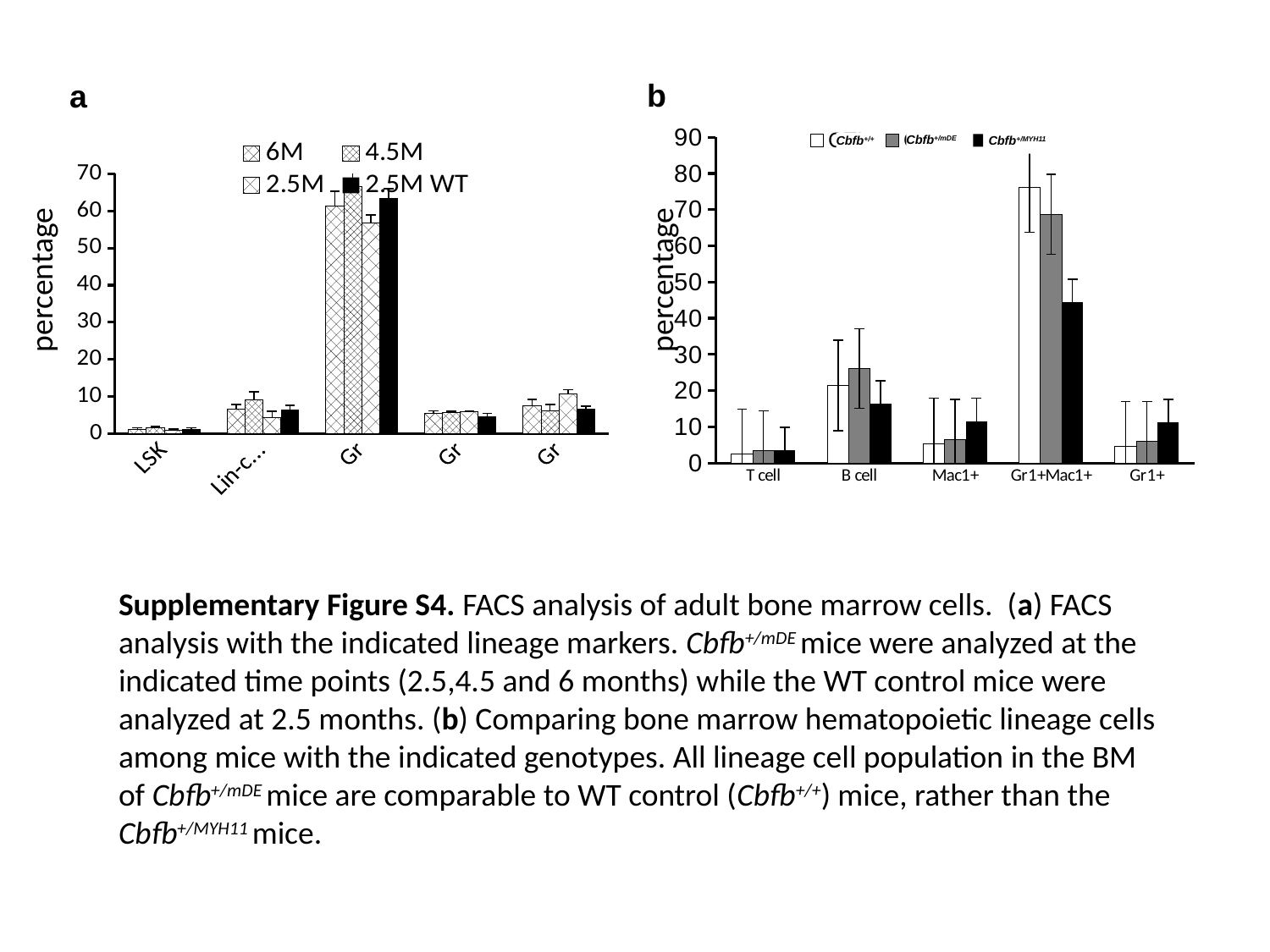
In the left chart (panel a), is the value for 6M in the Gr category with the tallest bars greater or less than 50? greater In the right chart (panel b), is the value for Cbfb+/+ in the Gr1+Mac1+ category greater or less than 70? greater In the right chart (panel b), which category has the highest values? Gr1+Mac1+ How many series does the legend of the right chart (panel b) list? 3 In the right chart (panel b), for the B cell category, which is larger: Cbfb+/mDE or Cbfb+/MYH11? Cbfb+/mDE How many categories are shown on the x axis of the right chart (panel b)? 5 How many series does the legend of the left chart (panel a) list? 4 In the right chart (panel b), is the value for Cbfb+/MYH11 in the Gr1+Mac1+ category greater or less than 50? less In the right chart (panel b), which category has the lowest values? T cell What kind of chart is the left chart (panel a)? bar chart What is the y-axis label of the left chart (panel a)? percentage